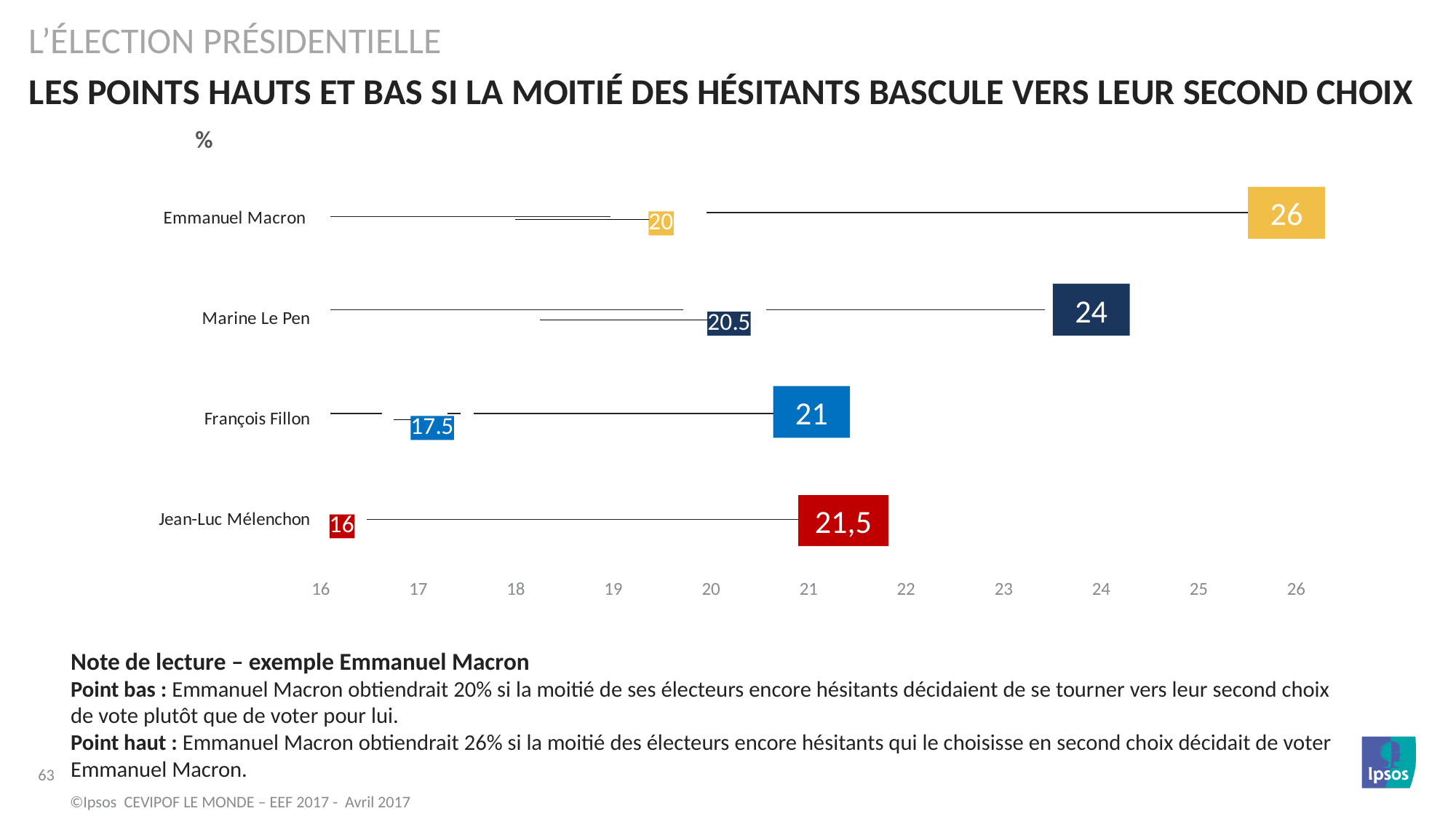
What is the low point (point bas) value for Emmanuel Macron? 20 What is the high point value for François Fillon? 21 What is the high point (point haut) value for Emmanuel Macron? 26 What is the low point value for Marine Le Pen? 20.5 What is the difference between Jean-Luc Mélenchon's high point and low point? 5.5 How many candidates are shown on the chart? 4 What is the difference between Emmanuel Macron's high point and low point? 6 What is the high point value for Jean-Luc Mélenchon? 21,5 What unit is indicated at the top of the chart's axis? % Which candidate has the highest high point value? Emmanuel Macron Which candidate has the lowest low point value? Jean-Luc Mélenchon Which is larger: Marine Le Pen's high point or François Fillon's high point? Marine Le Pen's high point